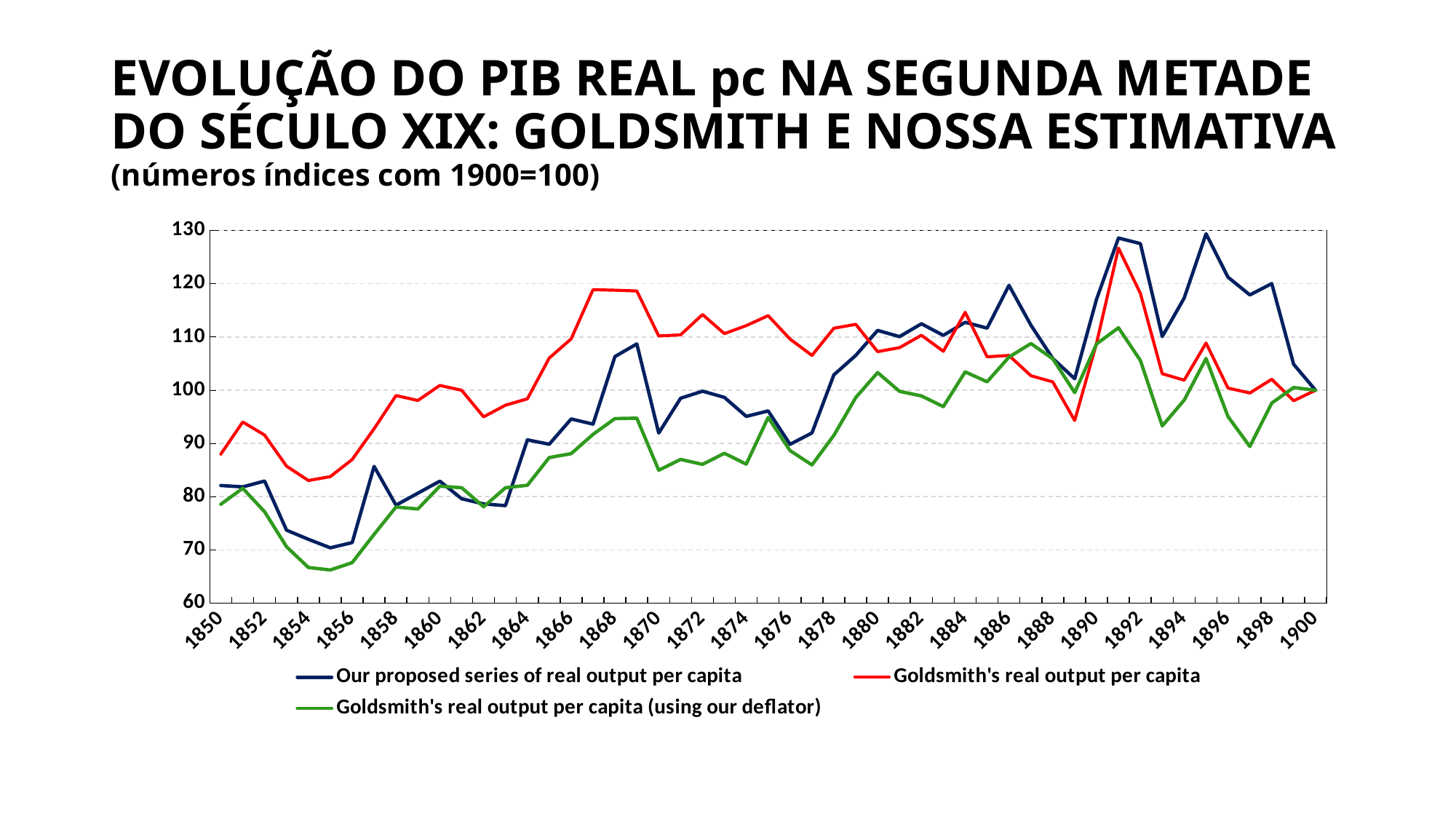
Which series reaches the lowest value anywhere on the chart? Goldsmith's real output per capita (using our deflator) In 1868, which is larger: Goldsmith's real output per capita or our proposed series of real output per capita? Goldsmith's real output per capita Overall, do the series rise or fall from 1850 to 1900? rise Is the value of our proposed series of real output per capita in 1895 greater or less than 120? greater What kind of chart is shown on the slide? line chart How many series does the legend list? 3 What is the value of our proposed series of real output per capita in 1900? 100 What is the value of Goldsmith's real output per capita in 1900? 100 In 1895, which is larger: our proposed series of real output per capita or Goldsmith's real output per capita (using our deflator)? Our proposed series of real output per capita Is the value of Goldsmith's real output per capita in 1868 greater or less than 110? greater Is the value of Goldsmith's real output per capita (using our deflator) in 1855 greater or less than 70? less